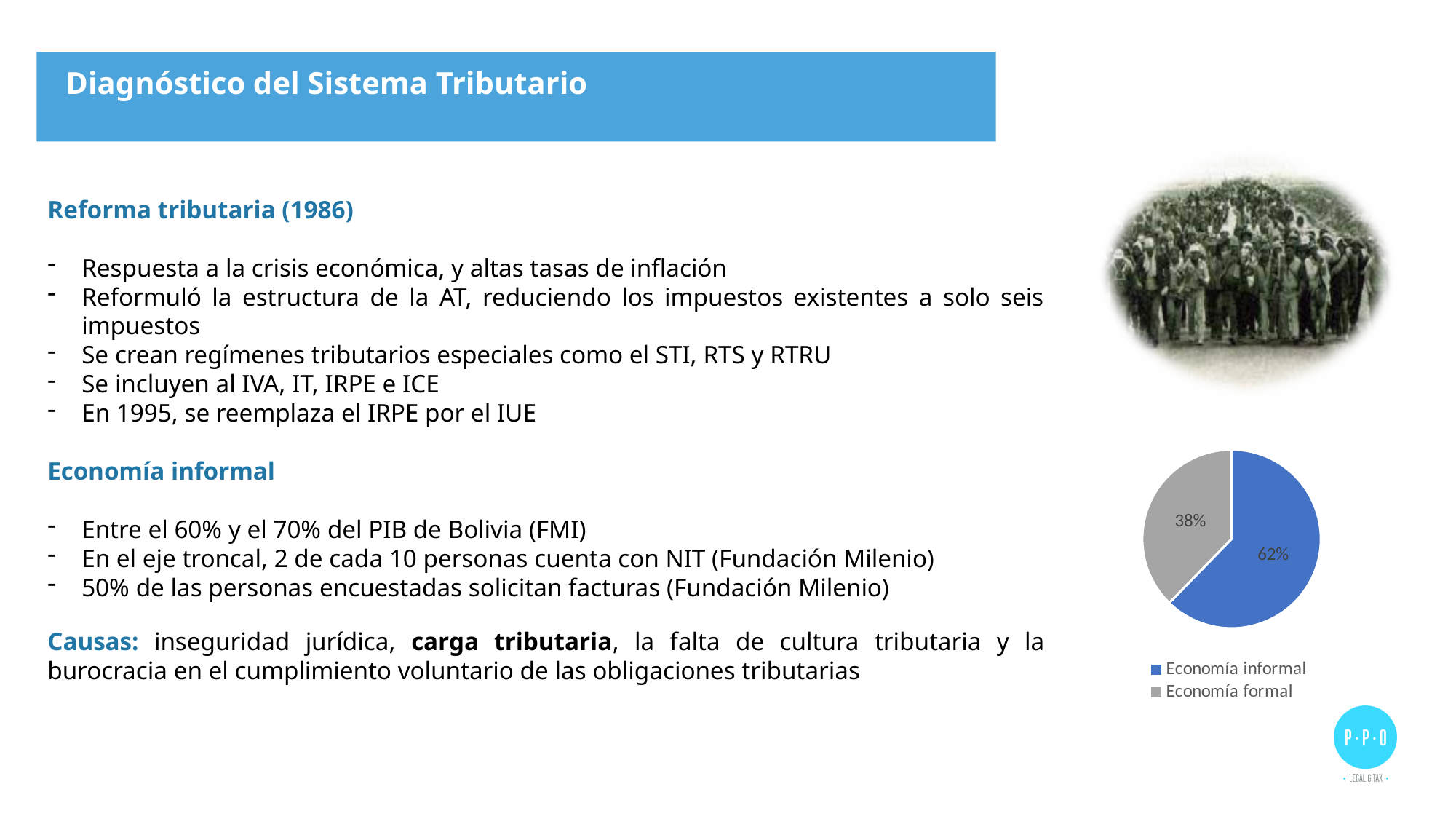
Which slice of the pie chart is the largest? Economía informal Which slice of the pie chart is the smallest? Economía formal How many entries does the pie chart legend list? 2 What share of the pie chart is labelled Economía informal? 62% What colour is the Economía informal slice in the pie chart? Blue What share of the pie chart is labelled Economía formal? 38% Which is larger in the pie chart, Economía informal or Economía formal? Economía informal What is the difference in percentage points between the Economía informal and Economía formal slices? 24 What colour is the Economía formal slice in the pie chart? Grey What kind of chart is shown on the slide? Pie chart How many slices does the pie chart have? 2